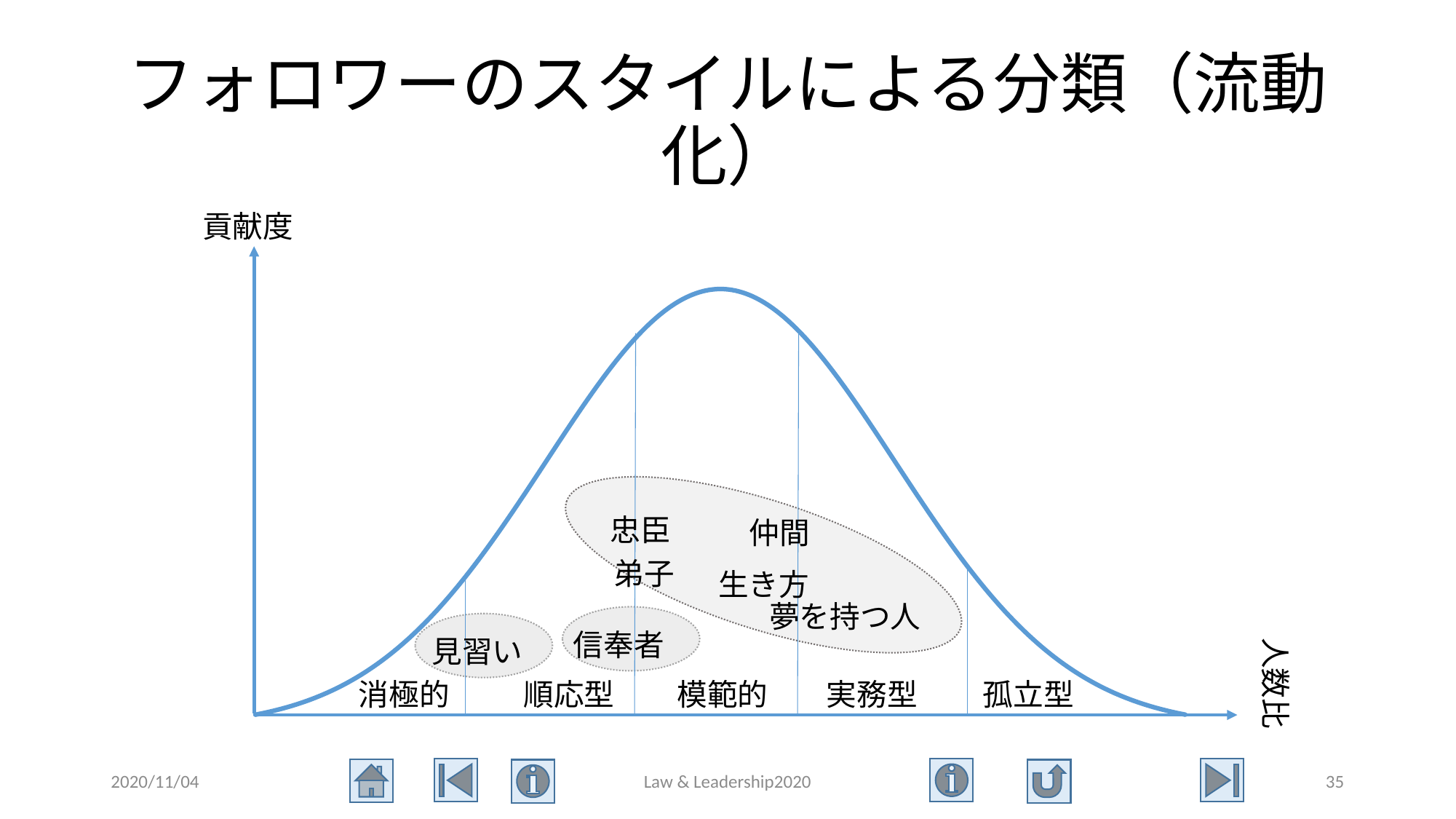
Which category has the curve higher, 順応型 or 孤立型? 順応型 Does the curve rise or fall moving from 消極的 to 模範的 along the x axis? rise What is the label on the vertical axis? 貢献度 What kind of chart is shown on the slide? line chart What is the label on the horizontal axis? 人数比 How many follower style categories are labeled along the x axis? 5 In which category does the peak of the curve fall? 模範的 Does the curve rise or fall moving from 模範的 to 孤立型 along the x axis? fall